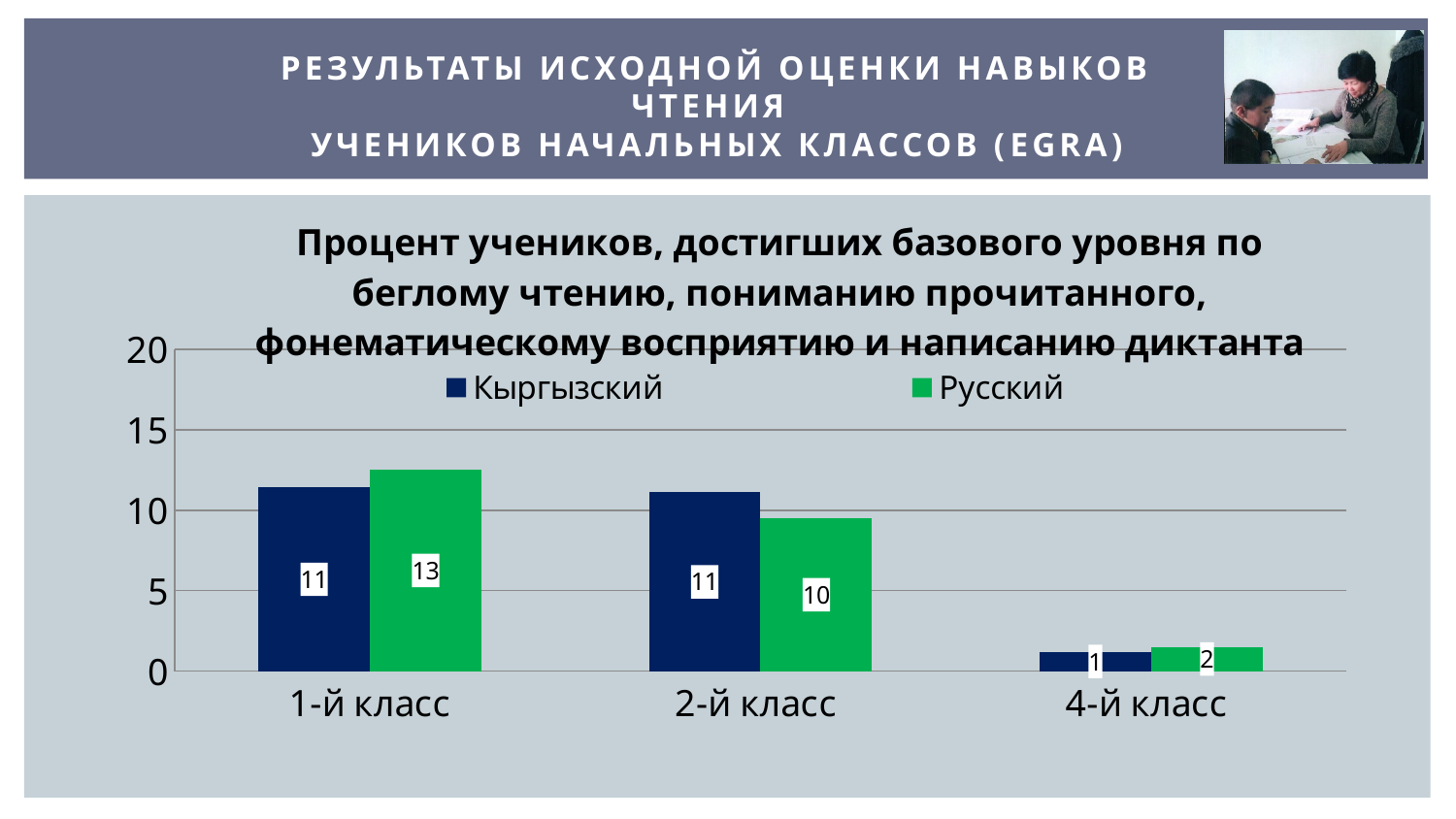
What kind of chart is shown on the slide? bar chart Which class has the highest value for Русский? 1-й класс What is the value for Русский in 2-й класс? 10 Which class has the lowest value for Русский? 4-й класс How many series does the legend list? 2 What is the value for Русский in 1-й класс? 13 In 2-й класс, which series has the larger value, Кыргызский or Русский? Кыргызский What is the value for Кыргызский in 4-й класс? 1 What is the difference between the Русский and Кыргызский values in 1-й класс? 2 Is the value for Русский in 1-й класс greater or less than 15? less How many classes are shown on the x axis? 3 What is the value for Кыргызский in 1-й класс? 11